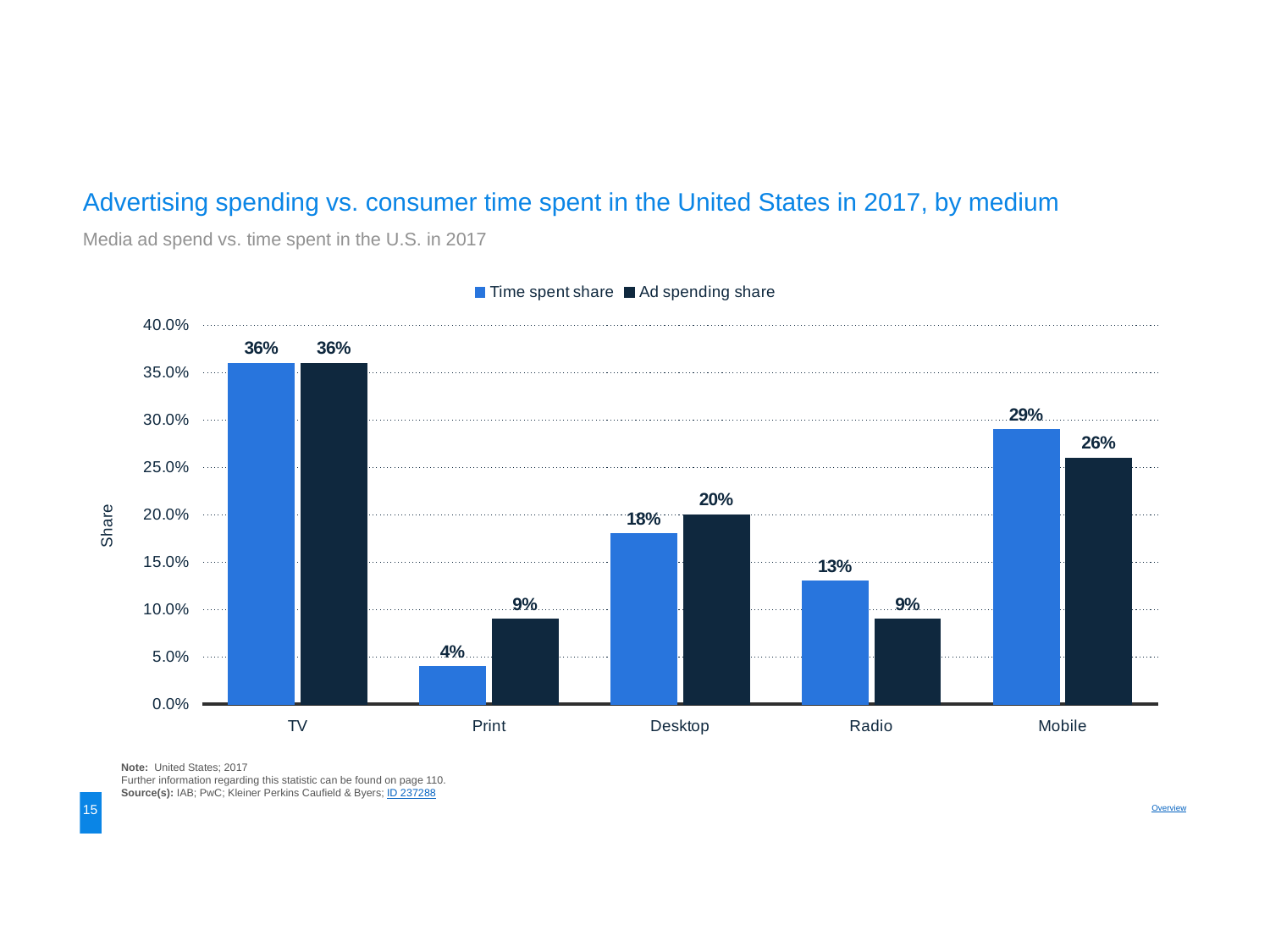
Which medium has the highest ad spending share? TV How many media categories are shown on the x axis? 5 What is the difference between the time spent share and the ad spending share for Radio? 4% Is the time spent share for Desktop greater or less than 20.0%? less What kind of chart is shown on the slide? Bar chart What is the ad spending share for Desktop? 20% What is the time spent share for Mobile? 29% What is the ad spending share for Print? 9% What is the difference between the ad spending share and the time spent share for Print? 5% Which medium has the lowest time spent share? Print Which is larger for Mobile, the time spent share or the ad spending share? Time spent share How many series does the legend list? 2